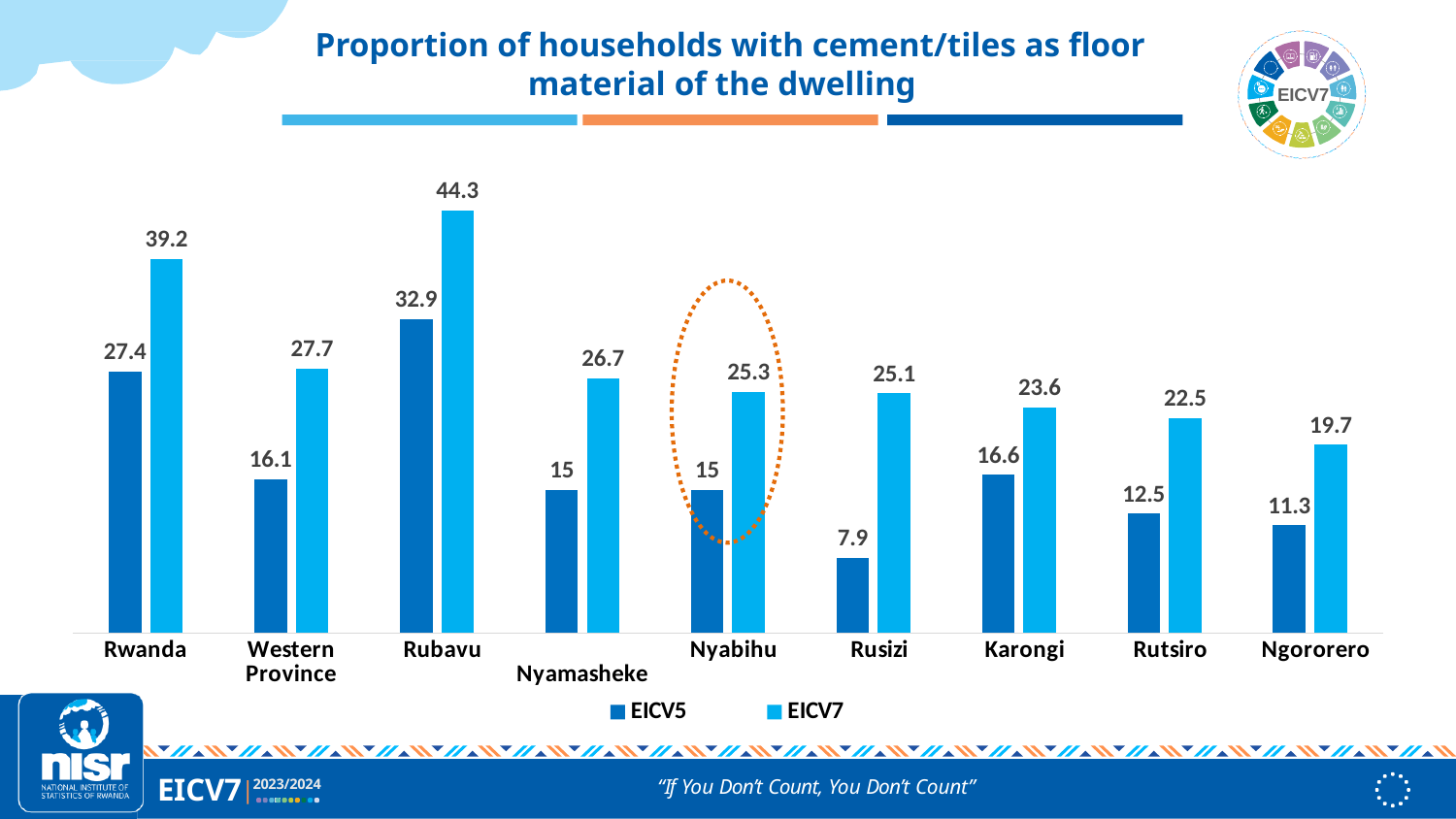
Which category has the lowest EICV5 value? Rusizi What is the difference between the EICV7 and EICV5 values for Rwanda? 11.8 What is the EICV5 value for Rusizi? 7.9 Which category is highlighted with a dotted orange oval? Nyabihu How many categories are shown on the x axis? 9 Which category has the highest EICV7 value? Rubavu What is the EICV7 value for Rubavu? 44.3 What is the EICV7 value for Western Province? 27.7 What is the EICV5 value for Nyabihu? 15 How many series does the legend list? 2 Which is larger, the EICV7 value for Karongi or the EICV7 value for Rutsiro? Karongi What kind of chart is shown on the slide? Bar chart